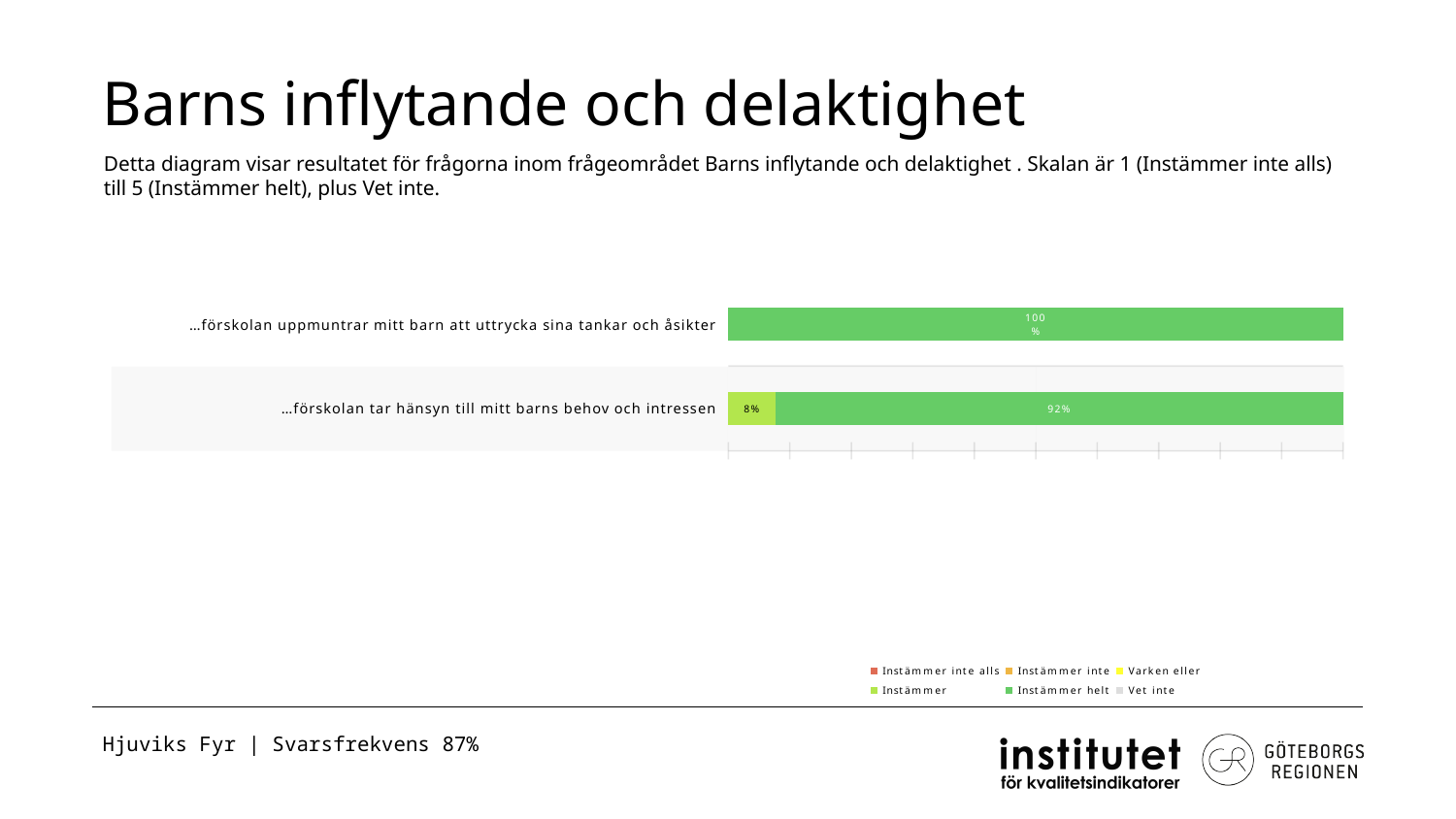
How many series does the legend list? 6 What is the 'Instämmer' value for '…förskolan tar hänsyn till mitt barns behov och intressen'? 8% Which category has the lower 'Instämmer helt' value? …förskolan tar hänsyn till mitt barns behov och intressen What is the total of the stacked bar for '…förskolan tar hänsyn till mitt barns behov och intressen'? 100% How many categories (questions) are plotted in the chart? 2 What is the 'Instämmer helt' value for '…förskolan uppmuntrar mitt barn att uttrycka sina tankar och åsikter'? 100% Which legend entry is shown in the darker green colour used for the largest segments? Instämmer helt Which category has the higher 'Instämmer helt' value? …förskolan uppmuntrar mitt barn att uttrycka sina tankar och åsikter Is the 'Instämmer helt' value for '…förskolan tar hänsyn till mitt barns behov och intressen' larger or smaller than its 'Instämmer' value? larger What is the difference between the 'Instämmer helt' values of the two categories? 8% What is the 'Instämmer helt' value for '…förskolan tar hänsyn till mitt barns behov och intressen'? 92% What kind of chart is shown on the slide? bar chart